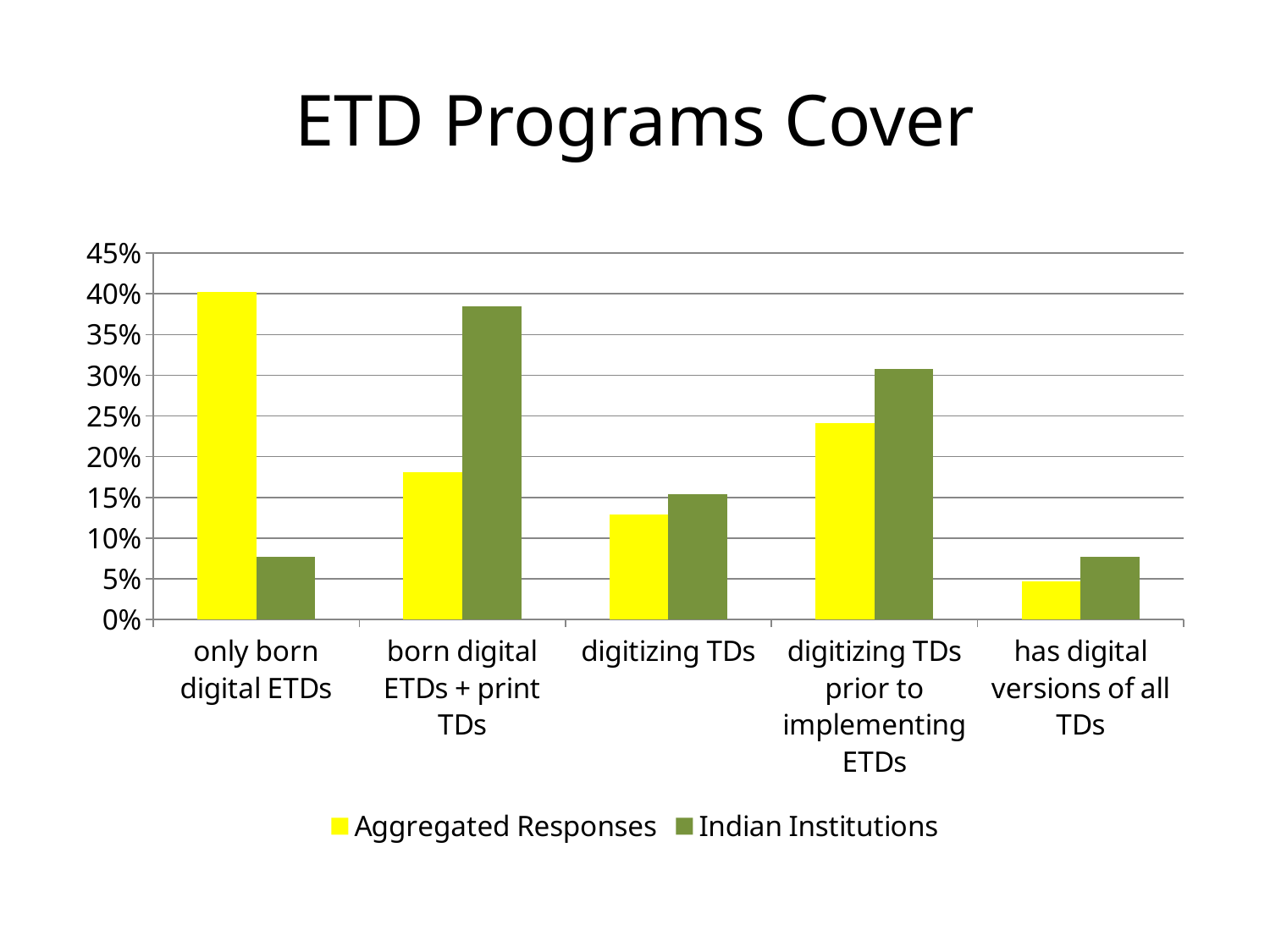
Is the Aggregated Responses value for has digital versions of all TDs greater or less than 10%? less Is the Indian Institutions value for born digital ETDs + print TDs greater or less than 35%? greater Is the Indian Institutions value for digitizing TDs prior to implementing ETDs greater or less than 25%? greater For only born digital ETDs, which series has the larger value, Aggregated Responses or Indian Institutions? Aggregated Responses Which category has the highest value for Aggregated Responses? only born digital ETDs What kind of chart is shown on the slide? bar chart How many series does the legend list? 2 What is the title of the chart? ETD Programs Cover Which category has the highest value for Indian Institutions? born digital ETDs + print TDs Which category has the lowest value for Aggregated Responses? has digital versions of all TDs How many categories are shown on the x axis? 5